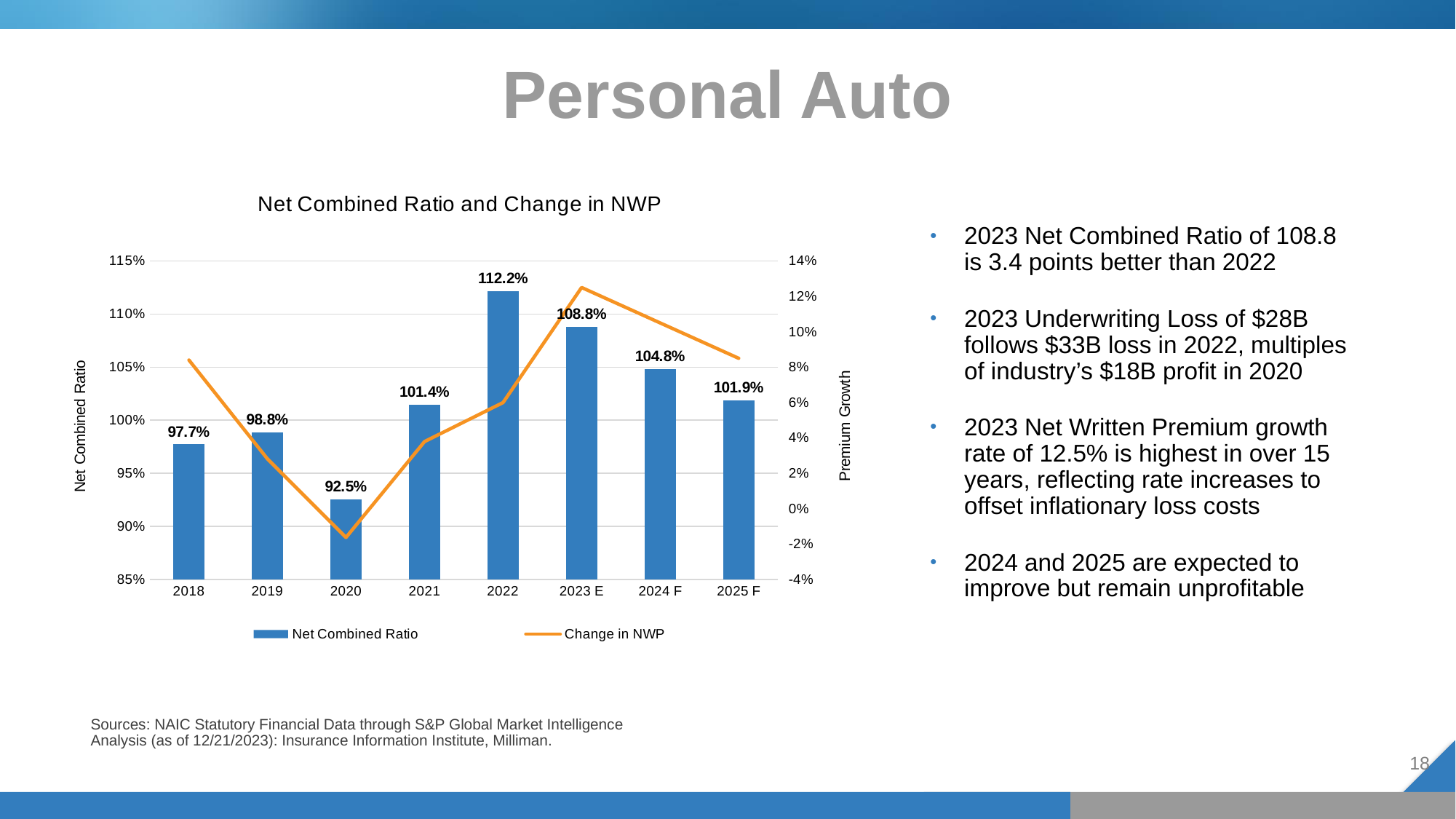
What is the Net Combined Ratio for 2025 F? 101.9% How many years are shown on the x axis? 8 What is the difference between the Net Combined Ratio in 2022 and in 2023 E? 3.4 percentage points Which year has the lowest Net Combined Ratio? 2020 What is the Net Combined Ratio for 2022? 112.2% Is the Change in NWP value for 2023 E greater or less than 10%? greater Which is larger, the Net Combined Ratio for 2019 or for 2021? 2021 Is the Change in NWP value for 2020 greater or less than 0%? less Which year has the highest Net Combined Ratio? 2022 How many series does the legend list? 2 What is the Net Combined Ratio for 2020? 92.5% What kind of chart is shown on the slide? A combination bar and line chart